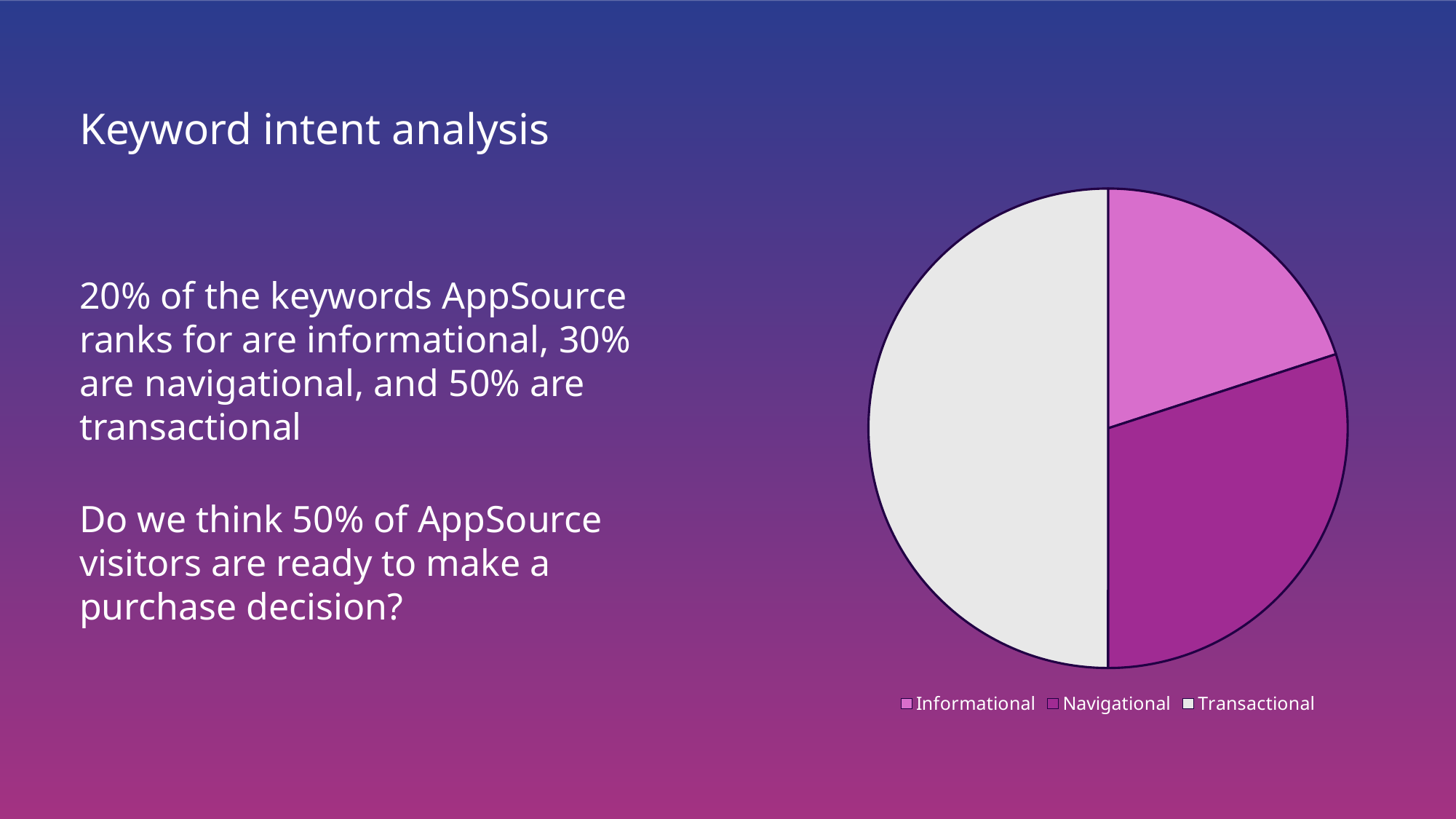
What colour is the Transactional slice of the pie chart? light grey How many slices does the pie chart have? 3 What are the legend entries of the pie chart, in order? Informational, Navigational, Transactional Which slice is larger in the pie chart, Transactional or Navigational? Transactional Which slice is larger in the pie chart, Navigational or Informational? Navigational Which category has the smallest slice of the pie chart? Informational According to the slide, what share of the keywords is navigational? 30% What kind of chart is shown on the slide? pie chart Which category has the largest slice of the pie chart? Transactional According to the slide, what share of the keywords is transactional? 50% According to the slide, what share of the keywords is informational? 20% How many entries does the legend of the pie chart list? 3